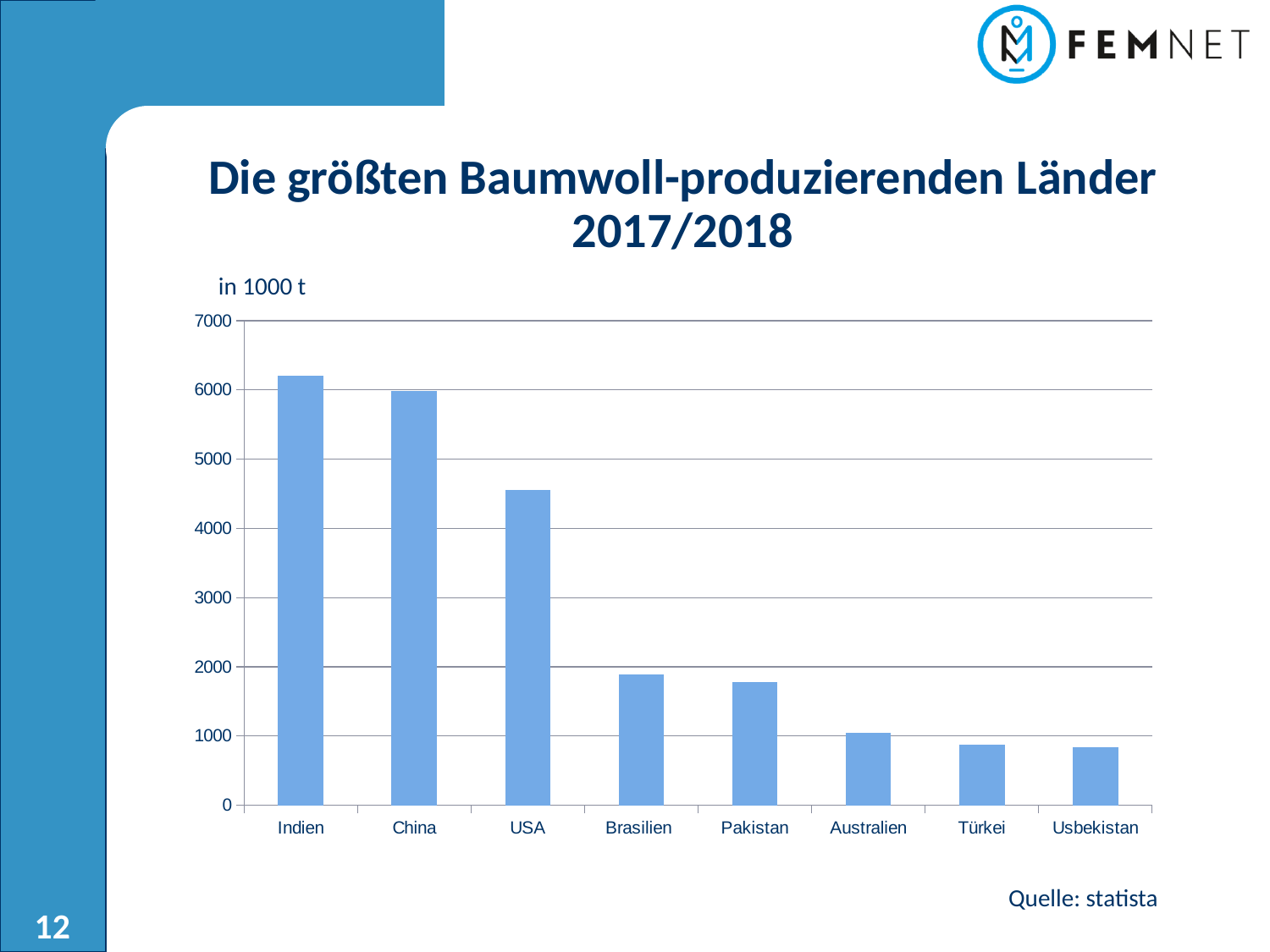
Which country has the highest cotton production in the chart? Indien Is the value for Indien greater or less than 6000? greater Is the value for USA greater or less than 4000? greater Is the value for Türkei greater or less than 1000? less Which has a larger value, USA or Brasilien? USA How many countries are shown in the chart? 8 What is the title of the chart? Die größten Baumwoll-produzierenden Länder 2017/2018 What kind of chart is shown on the slide? bar chart Do the values rise or fall from left to right along the x axis? fall What unit is given for the values in the chart? in 1000 t